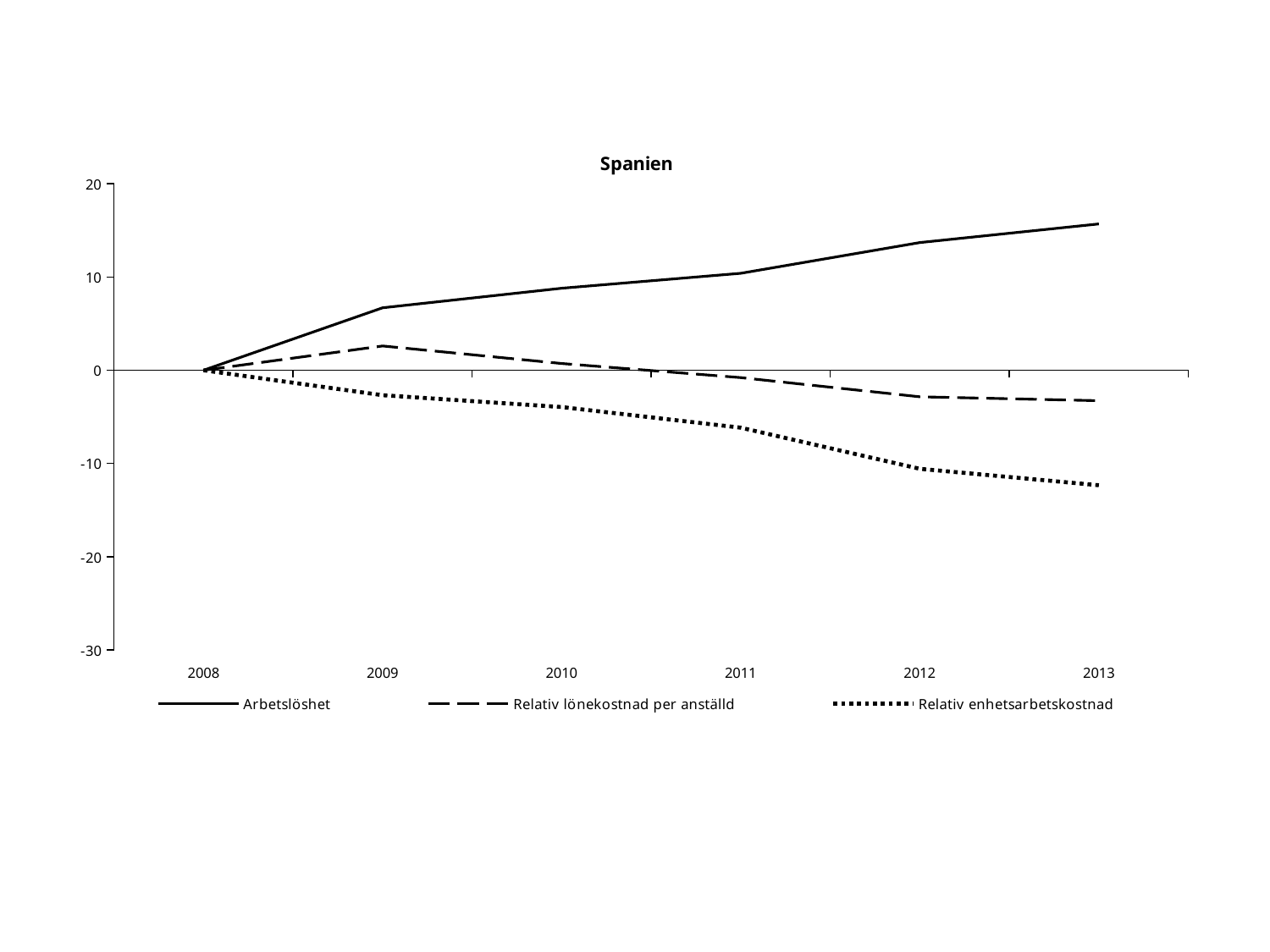
Which series has the highest value in 2013? Arbetslöshet Is the value for Relativ enhetsarbetskostnad in 2013 greater or less than -10? less What is the title of the chart? Spanien What is the value for Arbetslöshet in 2008? 0 In which year is Relativ enhetsarbetskostnad lowest? 2013 Is the value for Arbetslöshet in 2013 greater or less than 10? greater What kind of chart is shown on the slide? line chart How many years are shown on the x axis? 6 Is the value for Arbetslöshet in 2009 greater or less than 10? less How many series does the legend list? 3 Does the Arbetslöshet line rise or fall from 2008 to 2013? rise